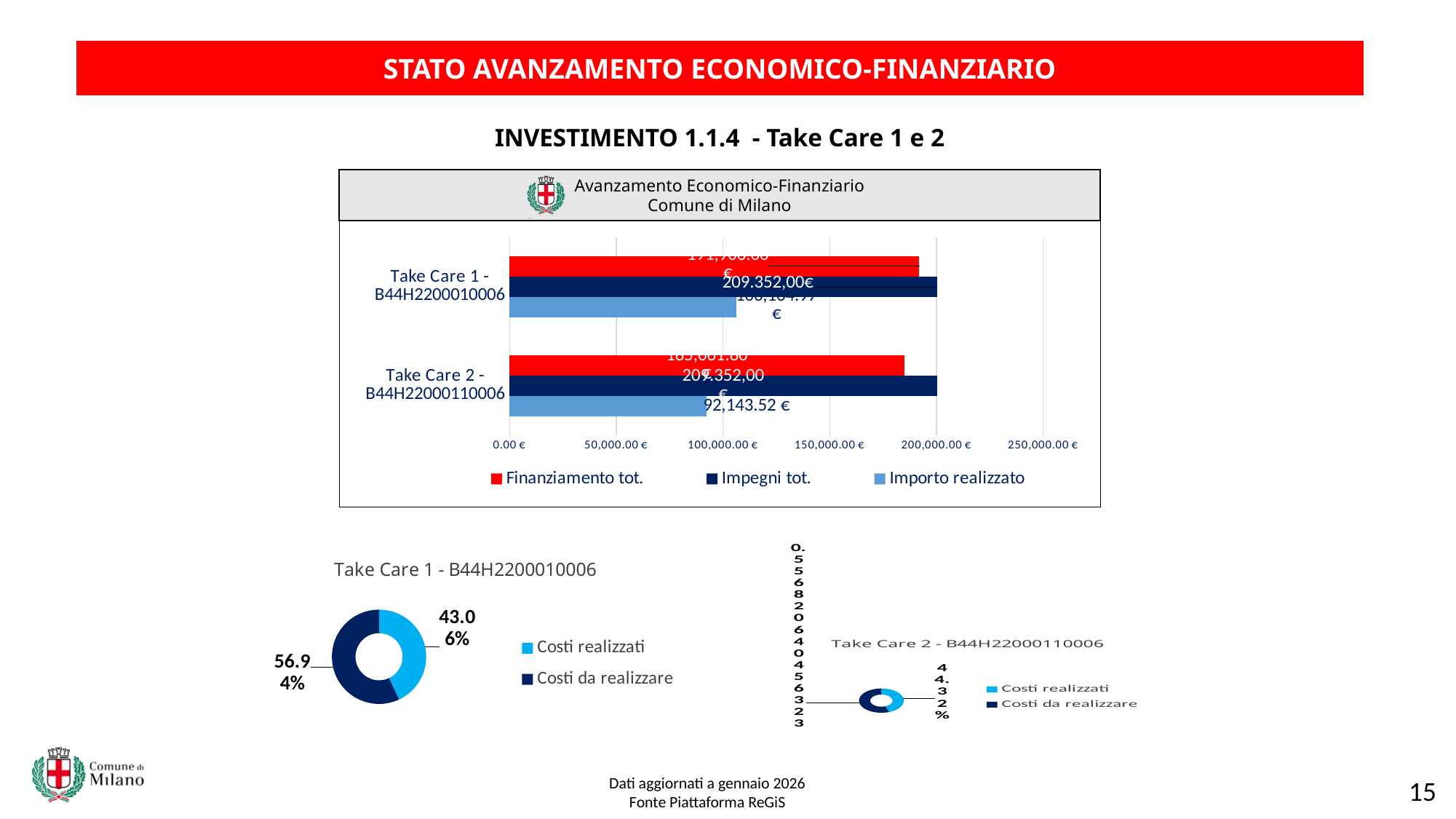
How many categories are shown on the top bar chart? 2 In the top bar chart, which series has the longest bar for Take Care 2? Impegni tot. What kind of chart is the top chart titled 'Avanzamento Economico-Finanziario Comune di Milano'? bar chart In the bottom-left doughnut chart 'Take Care 1 - B44H2200010006', which slice is larger, Costi realizzati or Costi da realizzare? Costi da realizzare How many series does the legend of the top bar chart list? 3 In the top bar chart, which colour represents Finanziamento tot.? red In the bottom-left doughnut chart 'Take Care 1 - B44H2200010006', what share is Costi realizzati? 43.06% In the top bar chart, is the Importo realizzato for Take Care 1 greater or less than 150,000.00 €? less In the top bar chart, is the Finanziamento tot. for Take Care 1 greater or less than 150,000.00 €? greater In the top bar chart, what is the Importo realizzato for Take Care 2 - B44H22000110006? 92,143.52 € In the top bar chart, which category has the larger Importo realizzato, Take Care 1 or Take Care 2? Take Care 1 In the top bar chart, what is the value of Impegni tot. for Take Care 1 - B44H2200010006? 209.352,00€